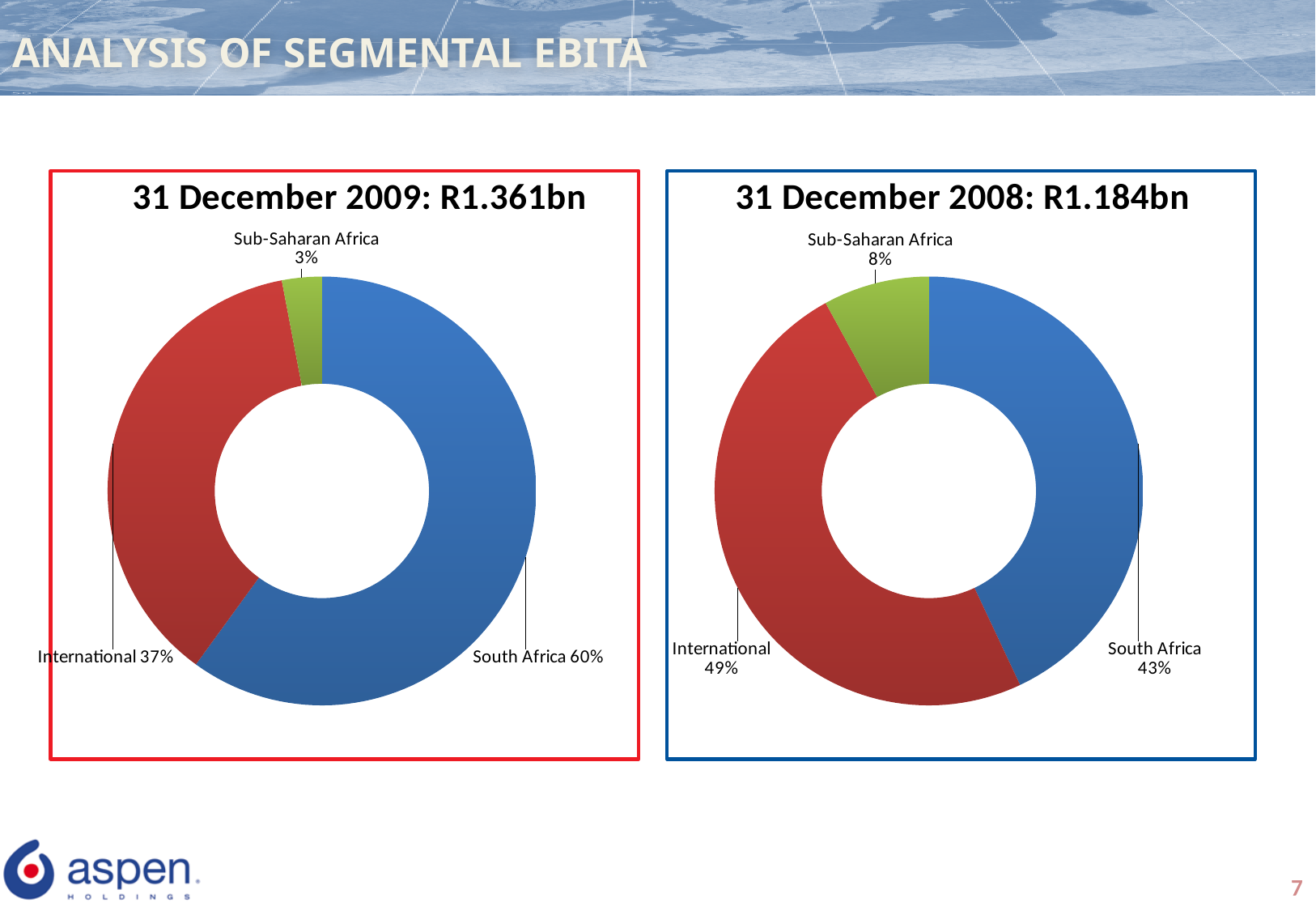
In the '31 December 2009: R1.361bn' chart, which segment has the largest share? South Africa What is the title of the chart on the right of the slide? 31 December 2008: R1.184bn In the '31 December 2008: R1.184bn' chart, which segment has the smallest share? Sub-Saharan Africa In the '31 December 2009: R1.361bn' chart, what share does Sub-Saharan Africa have? 3% In the '31 December 2008: R1.184bn' chart, what colour is the Sub-Saharan Africa segment? Green In the '31 December 2009: R1.361bn' chart, what share does South Africa have? 60% What type of chart is used on the left of the slide? Doughnut chart In the '31 December 2008: R1.184bn' chart, what share does Sub-Saharan Africa have? 8% In the '31 December 2008: R1.184bn' chart, which is larger, International or South Africa? International In the '31 December 2008: R1.184bn' chart, what share does International have? 49% In the '31 December 2009: R1.361bn' chart, what is the difference in percentage points between South Africa and International? 23 How many segments are shown in the '31 December 2009: R1.361bn' chart? 3